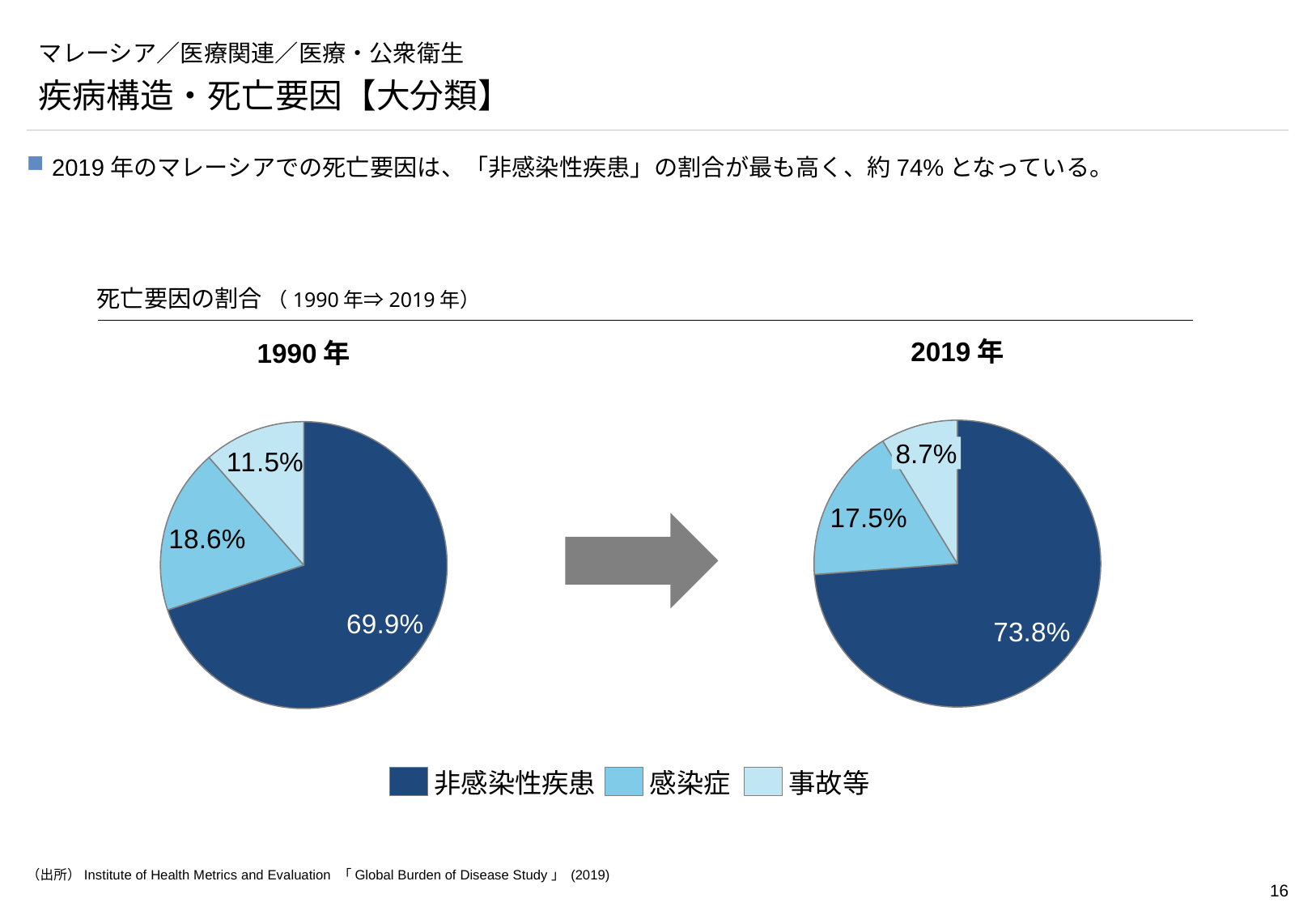
In the 1990年 pie chart, what is the share for 感染症? 18.6% How many categories does the legend list? 3 In the 1990年 pie chart, what is the share for 非感染性疾患? 69.9% What type of chart is used to show 死亡要因の割合 on this slide? Pie chart Which is larger: the 事故等 share in the 1990年 pie chart or in the 2019年 pie chart? 1990年 How many slices does the 2019年 pie chart have? 3 In the 1990年 pie chart, which category has the smallest share? 事故等 In the 1990年 pie chart, what is the difference between the 感染症 share and the 事故等 share? 7.1% In the 2019年 pie chart, what is the share for 事故等? 8.7% In the 2019年 pie chart, which category has the largest share? 非感染性疾患 What is the difference between the 非感染性疾患 share in the 2019年 pie chart and in the 1990年 pie chart? 3.9% In the 2019年 pie chart, what is the share for 感染症? 17.5%